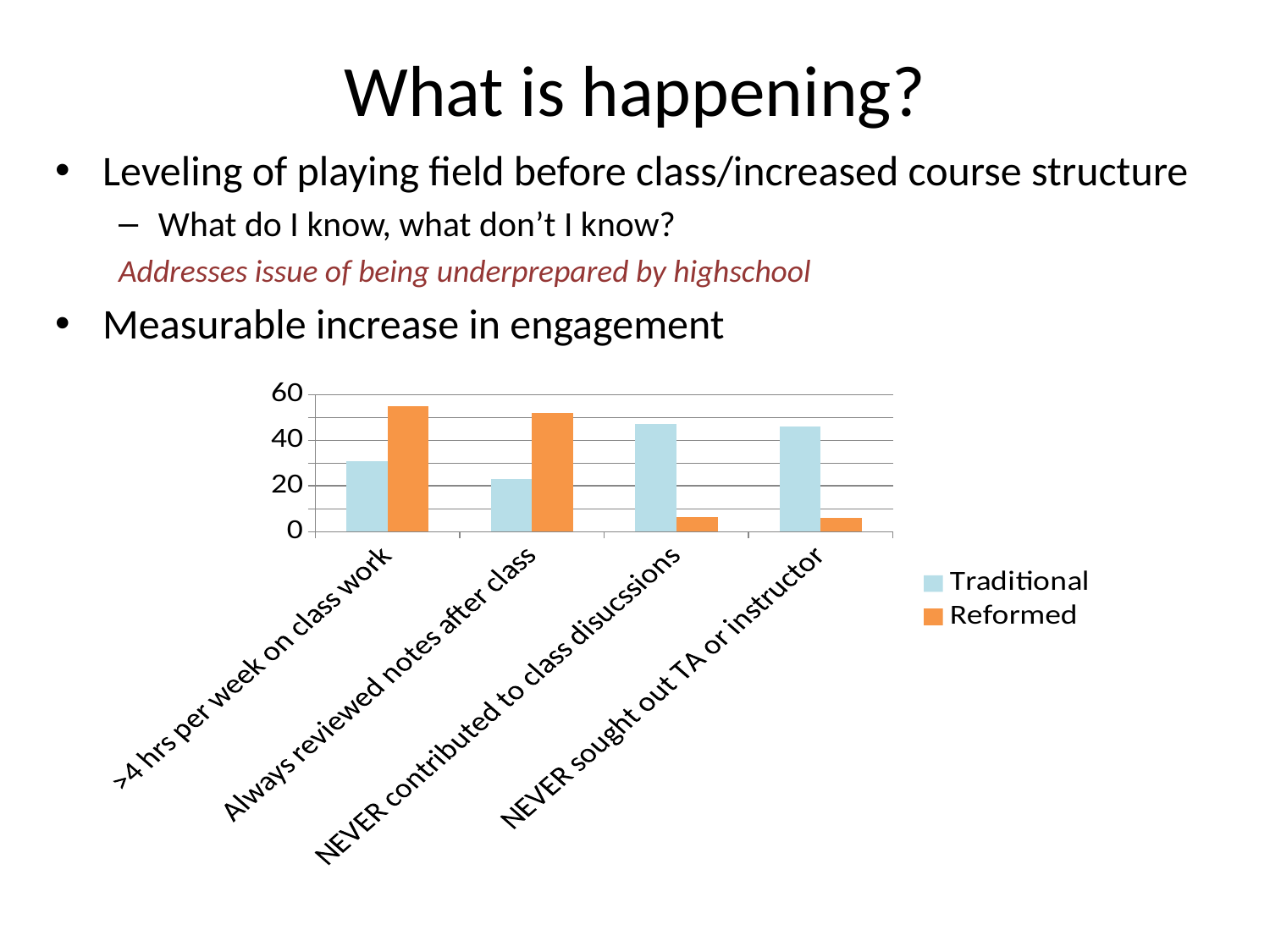
Is the Reformed value for 'NEVER contributed to class disucssions' greater or less than 20? less For '>4 hrs per week on class work', which series has the larger value, Traditional or Reformed? Reformed For 'NEVER sought out TA or instructor', which series has the larger value, Traditional or Reformed? Traditional What are the two series named in the chart legend? Traditional and Reformed Which series is shown in orange in the chart? Reformed Among the Traditional bars, which category has the lowest value? Always reviewed notes after class How many categories are shown on the x axis of the chart? 4 Is the Traditional value for 'Always reviewed notes after class' greater or less than 40? less How many series does the chart legend list? 2 For 'NEVER contributed to class disucssions', which series has the larger value, Traditional or Reformed? Traditional Is the Reformed value for '>4 hrs per week on class work' greater or less than 40? greater What kind of chart is shown on the slide? bar chart